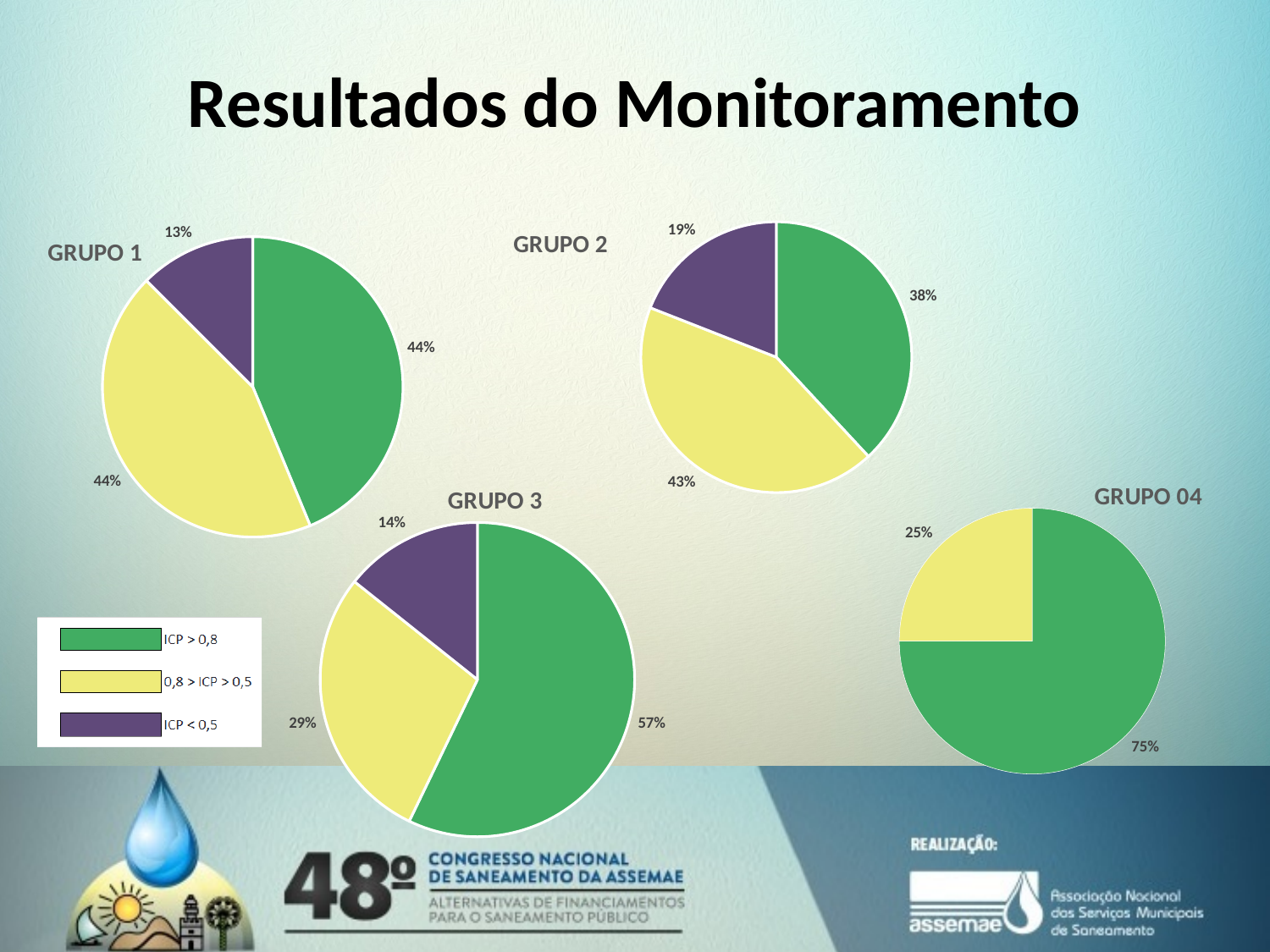
Which colour represents ICP < 0,5 in the legend? Purple How many categories does the legend list? 3 In the GRUPO 04 pie chart, what share does the 0,8 > ICP > 0,5 slice have? 25% In the GRUPO 1 pie chart, what share is labelled for the ICP < 0,5 slice? 13% In the GRUPO 2 pie chart, which is larger: the ICP > 0,8 slice or the ICP < 0,5 slice? ICP > 0,8 In the GRUPO 3 pie chart, what share does the ICP > 0,8 slice have? 57% What type of chart is used for GRUPO 1? Pie chart In the GRUPO 2 pie chart, what share does the 0,8 > ICP > 0,5 slice have? 43% How many slices does the GRUPO 04 pie chart have? 2 In the GRUPO 2 pie chart, which category has the largest share? 0,8 > ICP > 0,5 In the GRUPO 3 pie chart, what is the difference between the ICP > 0,8 share and the 0,8 > ICP > 0,5 share? 28% In the GRUPO 3 pie chart, which category has the smallest share? ICP < 0,5